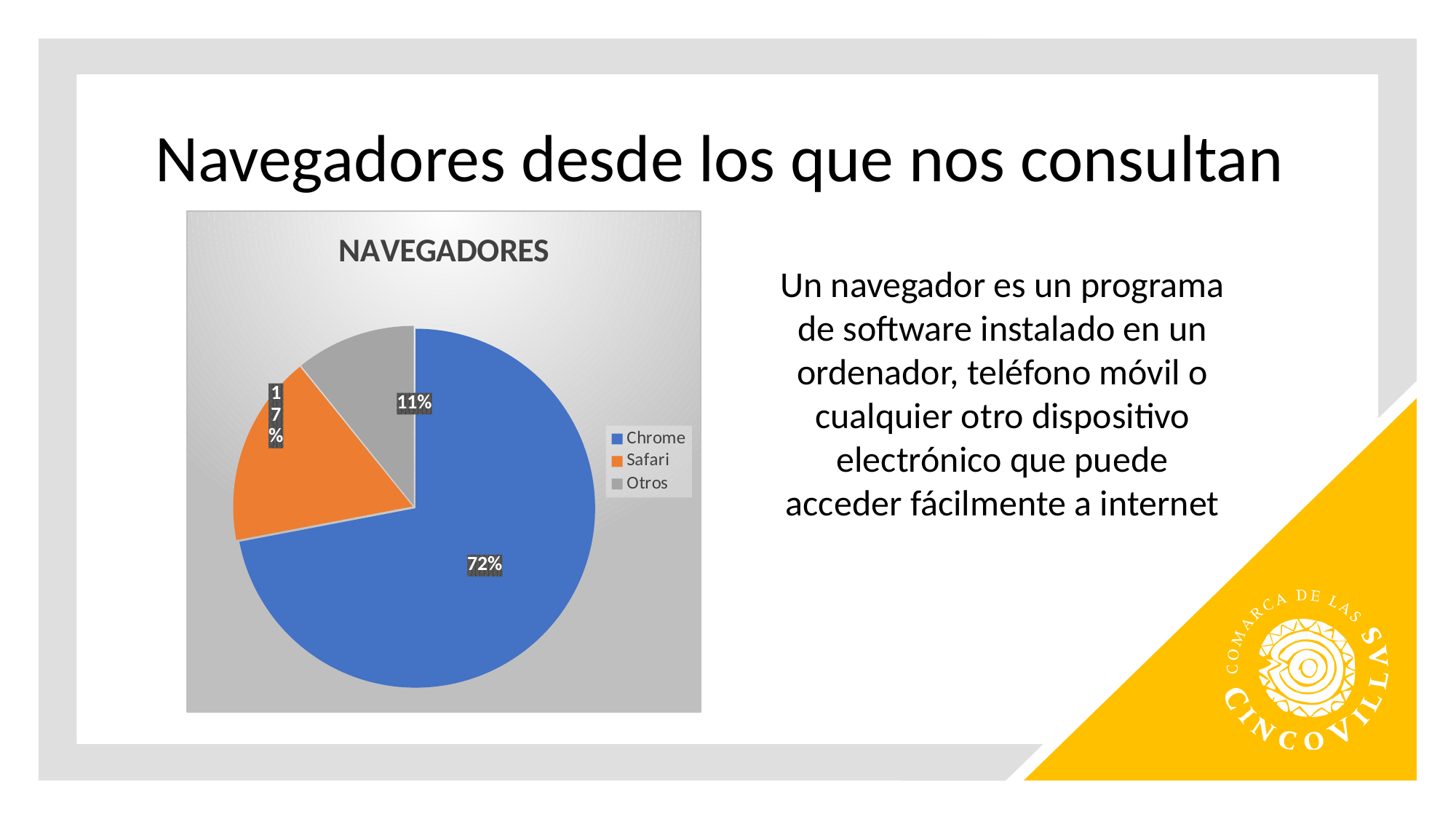
Which category has the largest slice of the pie? Chrome What type of chart is shown on the slide? pie chart What share of the pie does Otros have? 11% What is the difference between the Safari share and the Otros share? 6% What colour is the Safari slice in the pie chart? orange How many categories does the pie chart show? 3 Which is larger, the Safari slice or the Otros slice? Safari What is the difference between the Chrome share and the Safari share? 55% What share of the pie does Chrome have? 72% What share of the pie does Safari have? 17% What is the title of the chart? NAVEGADORES Which category has the smallest slice of the pie? Otros